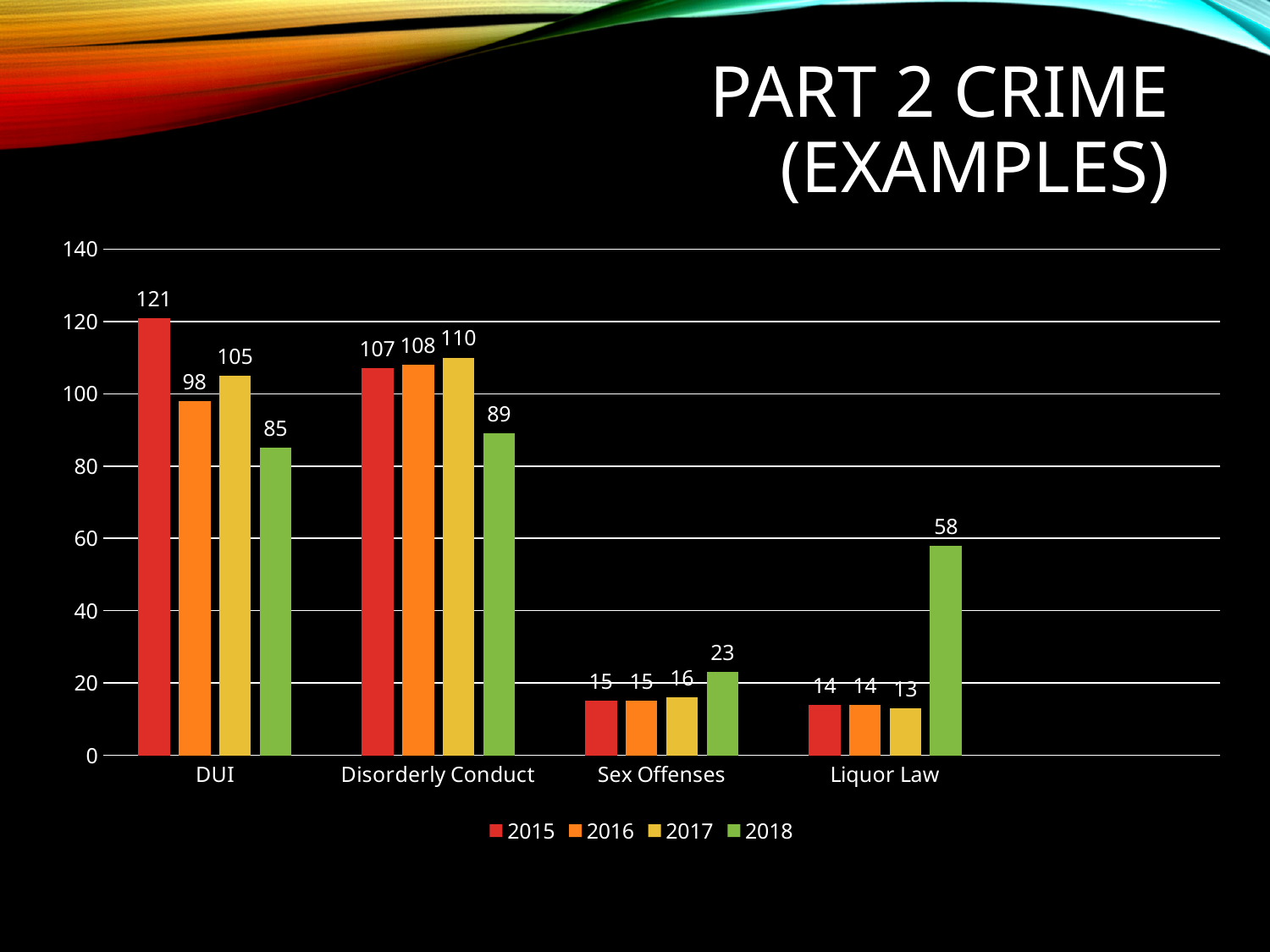
What is the value for Sex Offenses in 2017? 16 Which category has the lowest value in 2017? Liquor Law Which colour represents the 2018 series in the legend? Green Is the value for Liquor Law in 2018 greater or less than 40? greater What is the value for DUI in 2015? 121 How many series does the legend list? 4 Which category has the highest value in 2018? Disorderly Conduct How many categories are shown on the x axis? 4 What is the difference between the 2015 and 2018 values for DUI? 36 What kind of chart is shown on the slide? Bar chart Which is larger, the 2016 value for DUI or the 2016 value for Disorderly Conduct? Disorderly Conduct What is the value for Liquor Law in 2018? 58